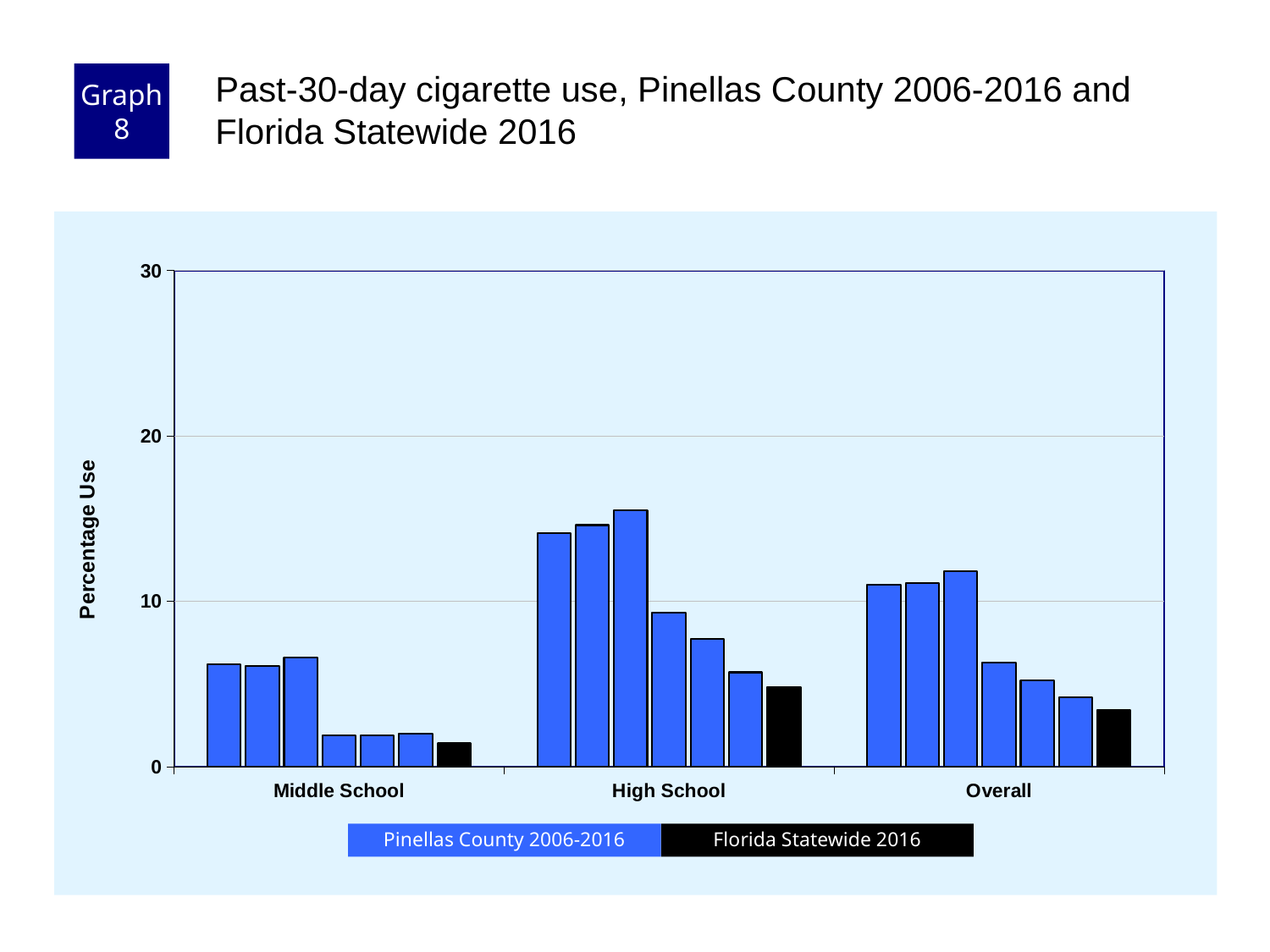
What is the label on the y axis? Percentage Use Which series is shown in black according to the legend? Florida Statewide 2016 Is the value of the first Pinellas County bar in the High School group greater or less than 10? greater Which category group has the lowest bars overall? Middle School In the High School group, is the last Pinellas County bar higher or lower than the first Pinellas County bar? lower Which is larger: the Florida Statewide 2016 bar for High School or the Florida Statewide 2016 bar for Middle School? High School Is the value of the tallest Pinellas County bar in the Middle School group greater or less than 10? less How many school-level categories are shown along the x axis? 3 Is the value of the Florida Statewide 2016 bar in the High School group greater or less than 10? less What kind of chart is shown on the slide? bar chart How many series does the legend list? 2 Which category group contains the tallest bar in the chart? High School